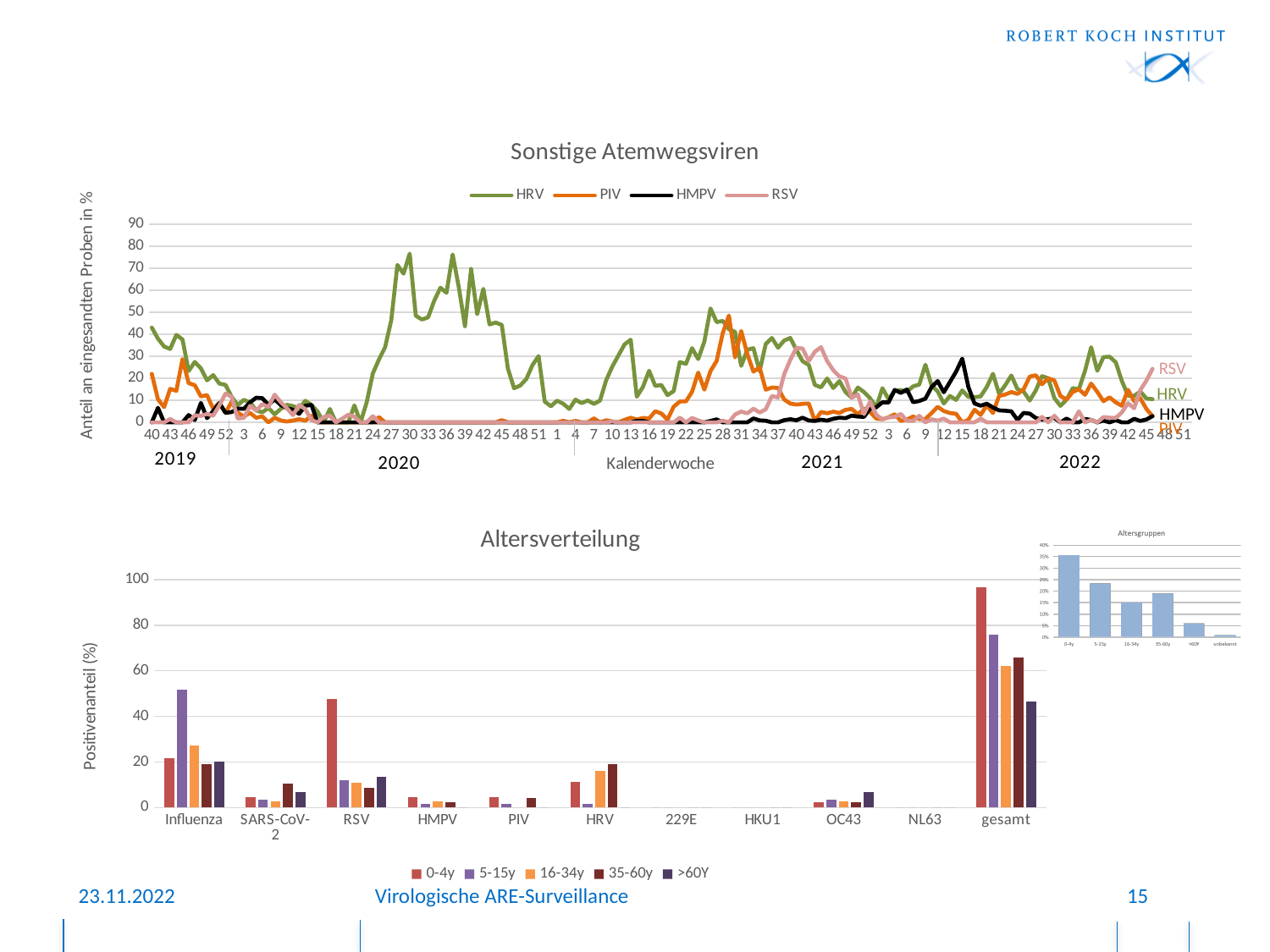
In the 'Altersverteilung' chart, which age group has the highest value for Influenza? 5-15y How many series does the legend of the 'Altersverteilung' chart list? 5 In the 'Sonstige Atemwegsviren' chart, is the highest value reached by HRV greater or less than 70? greater In the small 'Altersgruppen' chart at the top right, which category has the highest bar? 0-4y How many categories are shown on the x axis of the 'Altersverteilung' chart? 11 In the 'Sonstige Atemwegsviren' chart, which series reaches the highest value over the whole period? HRV What kind of chart is the top chart titled 'Sonstige Atemwegsviren'? line chart In the 'Altersverteilung' chart, which is larger for the 0-4y group: Influenza or RSV? RSV What kind of chart is the 'Altersverteilung' chart? bar chart In the 'Altersverteilung' chart, is the value for 0-4y in the 'gesamt' category greater or less than 80? greater How many series does the legend of the 'Sonstige Atemwegsviren' chart list? 4 In the 'Sonstige Atemwegsviren' chart, which series is drawn in black? HMPV